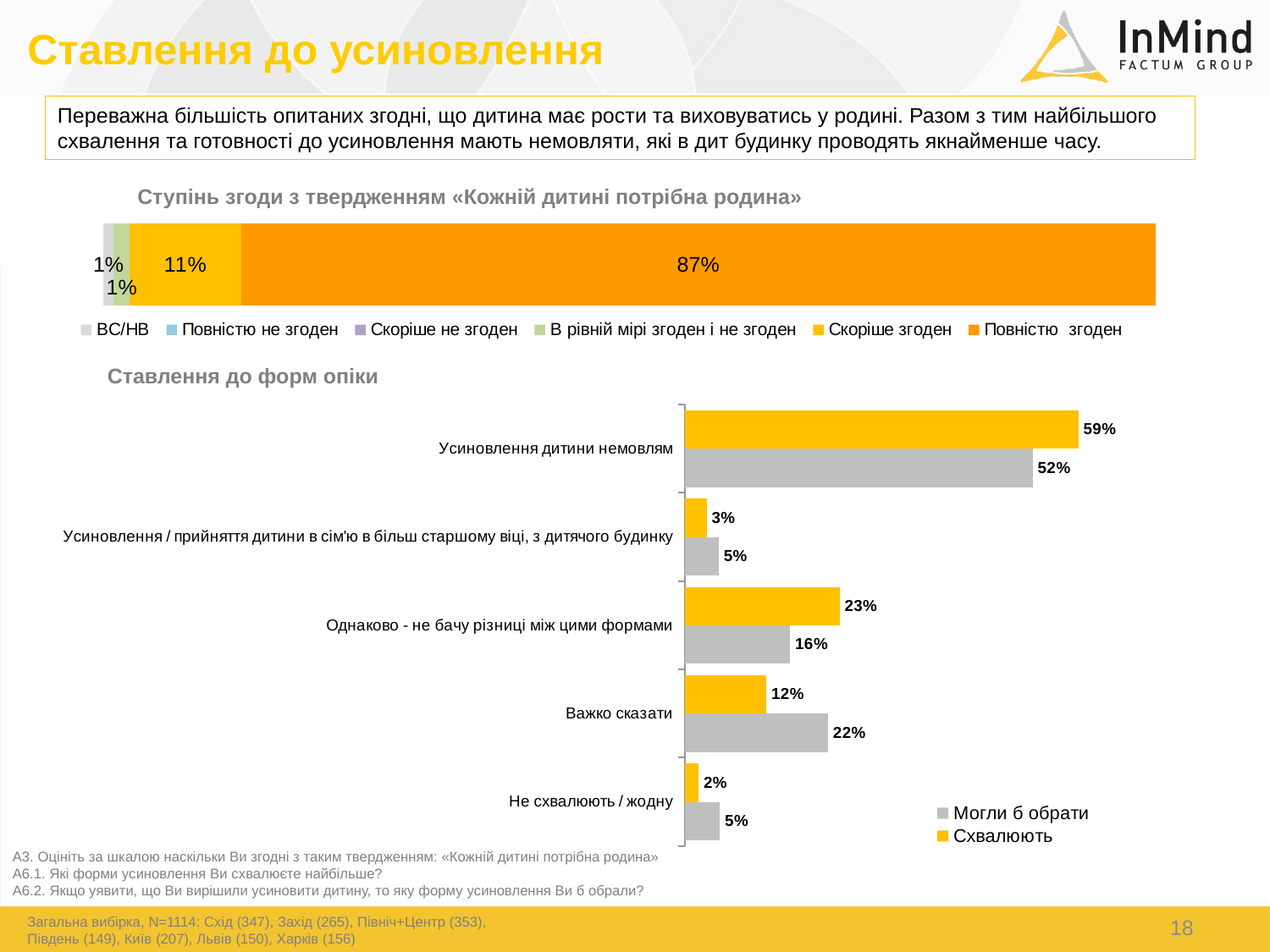
In the chart 'Ставлення до форм опіки', for 'Важко сказати', which is larger: 'Схвалюють' or 'Могли б обрати'? Могли б обрати In the chart 'Ставлення до форм опіки', what is the 'Схвалюють' value for 'Усиновлення дитини немовлям'? 59% What kind of chart is 'Ставлення до форм опіки'? Bar chart In the chart 'Ставлення до форм опіки', what is the difference between the 'Схвалюють' and 'Могли б обрати' values for 'Усиновлення дитини немовлям'? 7% How many series does the legend of the chart 'Ставлення до форм опіки' list? 2 In the chart 'Ставлення до форм опіки', what is the 'Могли б обрати' value for 'Однаково - не бачу різниці між цими формами'? 16% How many categories are shown in the chart 'Ставлення до форм опіки'? 5 In the chart 'Ставлення до форм опіки', which category has the lowest 'Схвалюють' value? Не схвалюють / жодну How many entries does the legend of the top chart 'Ступінь згоди з твердженням «Кожній дитині потрібна родина»' list? 6 In the top chart 'Ступінь згоди з твердженням «Кожній дитині потрібна родина»', what is the value for 'Повністю згоден'? 87% In the chart 'Ставлення до форм опіки', what is the 'Могли б обрати' value for 'Важко сказати'? 22% In the chart 'Ставлення до форм опіки', which category has the highest 'Схвалюють' value? Усиновлення дитини немовлям